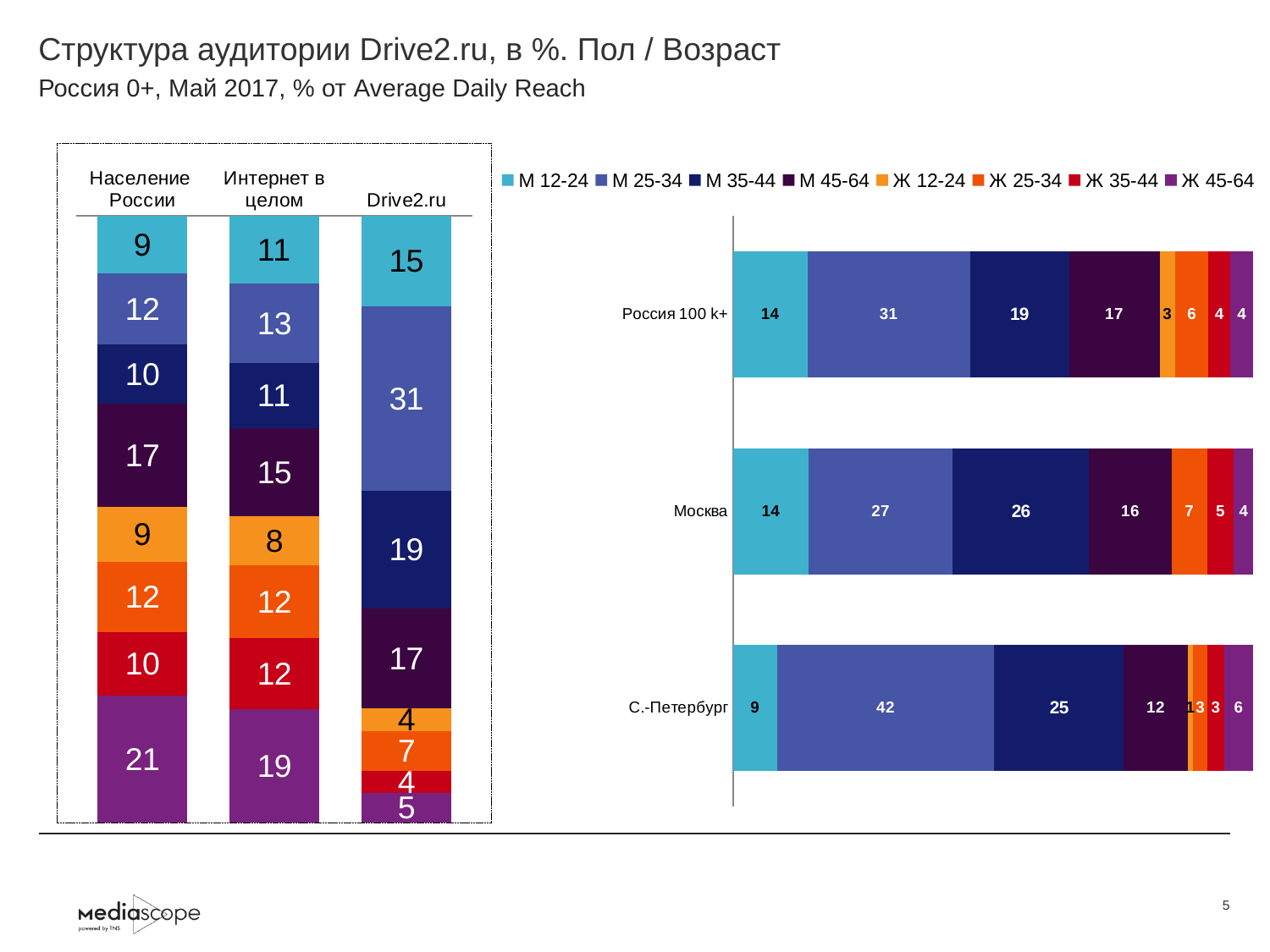
In the right chart, what is the value of the М 35-44 segment for Москва? 26 In the right chart, what is the value of the М 25-34 segment for С.-Петербург? 42 In the right chart, which bar has the smallest М 12-24 segment? С.-Петербург In the left chart, what is the difference between the top segment of the Drive2.ru bar and the top segment of the Население России bar? 6 In the right chart, what is the difference between the М 35-44 values for Москва and Россия 100 k+? 7 In the left chart, what is the value of the bottom segment of the Население России bar? 21 In the right chart, what is the value of the М 12-24 segment for Россия 100 k+? 14 In the left chart, what is the value of the largest segment in the Drive2.ru bar? 31 In the right chart, is the М 45-64 value larger for Россия 100 k+ or for С.-Петербург? Россия 100 k+ In the right chart, which city or region has the largest М 25-34 segment? С.-Петербург How many series does the legend of the right chart list? 8 What type of chart is the chart on the right side of the slide? Stacked horizontal bar chart